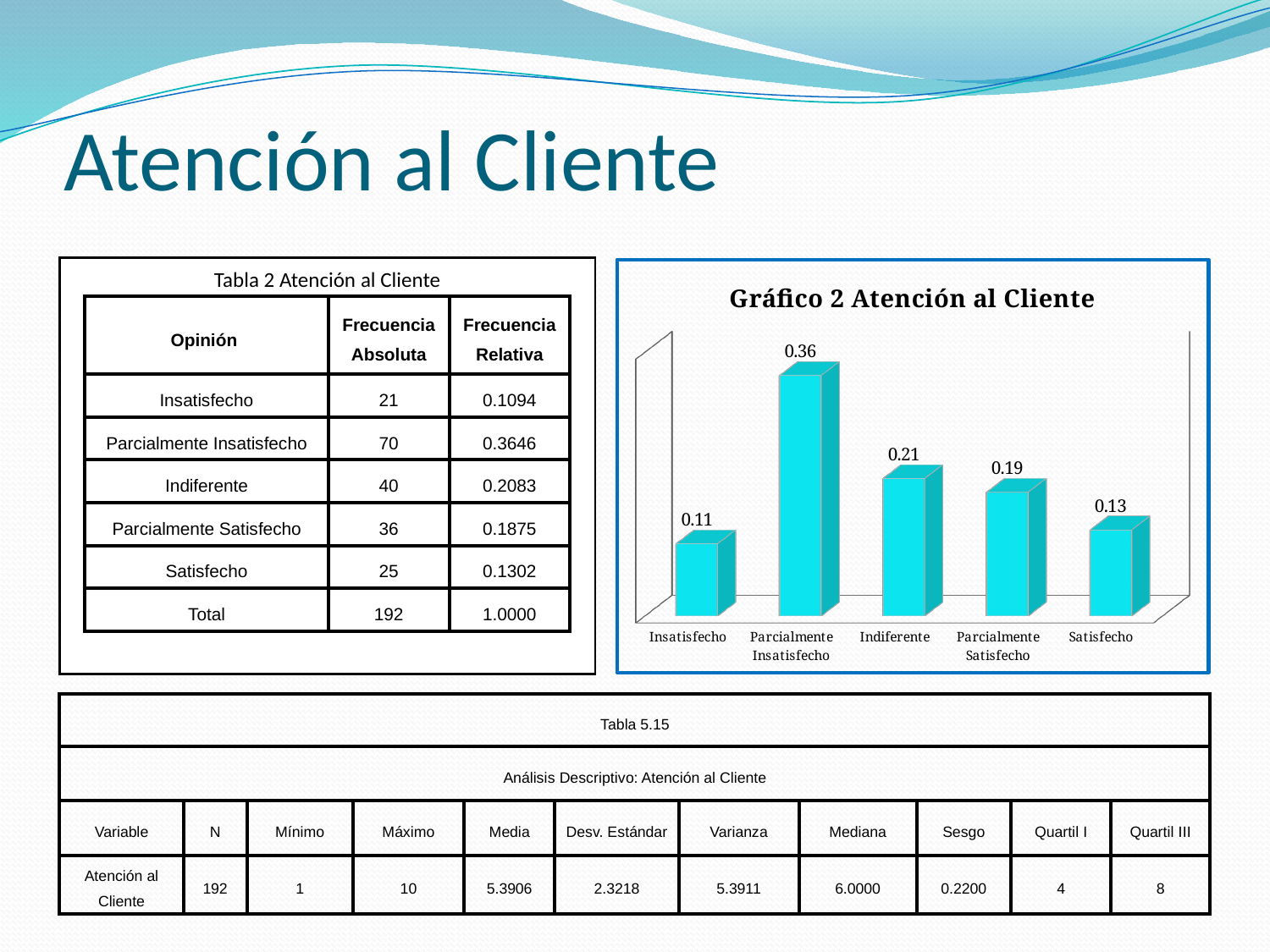
Which category has the lowest value in the chart? Insatisfecho Which is larger, the value for Indiferente or the value for Parcialmente Satisfecho? Indiferente What kind of chart is shown on the slide? Bar chart What is the value for Satisfecho in the chart? 0.13 What is the value for Insatisfecho in the chart? 0.11 What is the value for Parcialmente Insatisfecho in the chart? 0.36 What is the difference between the values for Parcialmente Satisfecho and Satisfecho? 0.06 What is the difference between the values for Parcialmente Insatisfecho and Indiferente? 0.15 What is the value for Indiferente in the chart? 0.21 How many categories are shown in the chart? 5 What is the title of the chart? Gráfico 2 Atención al Cliente Which category has the highest value in the chart? Parcialmente Insatisfecho